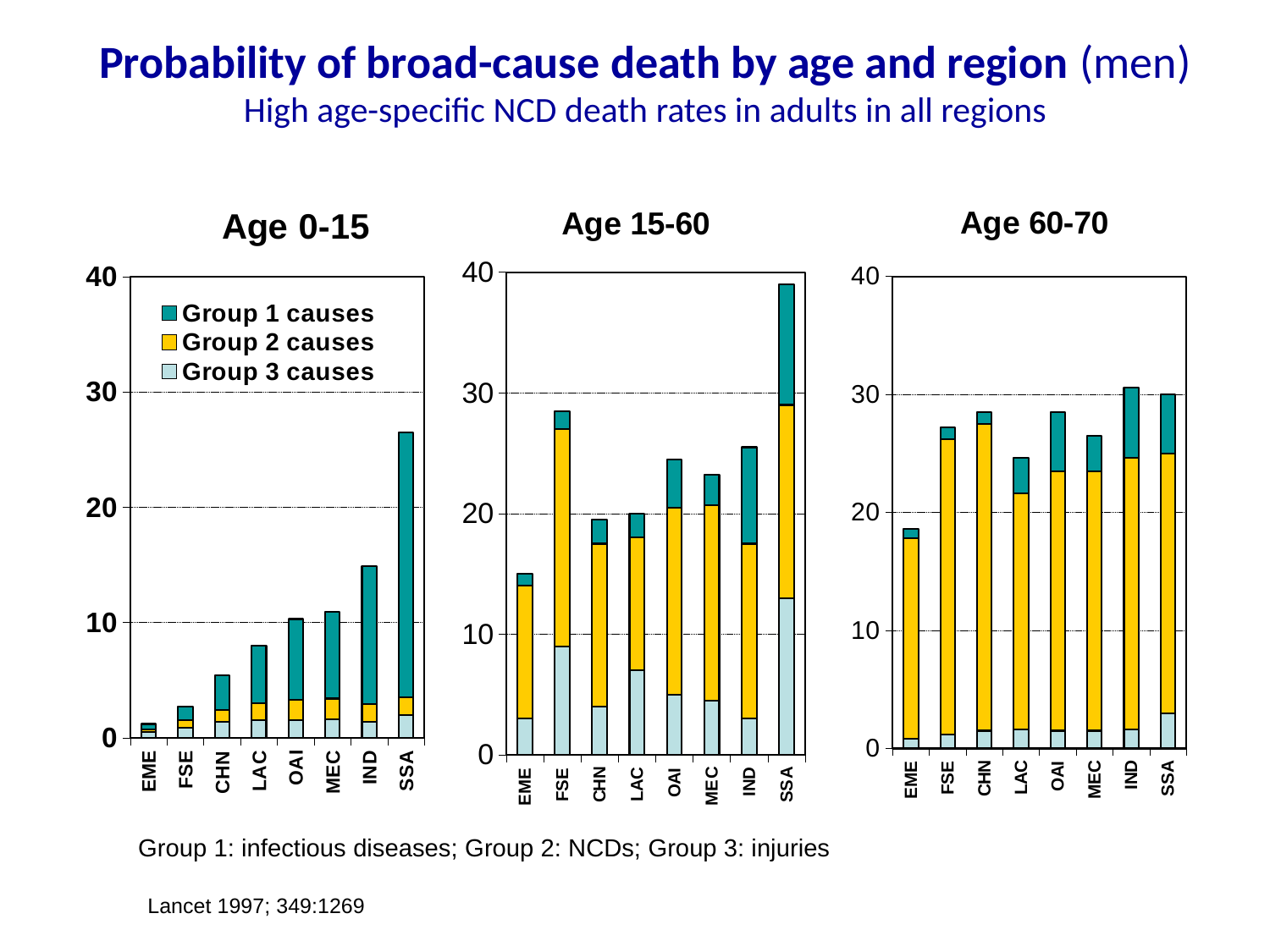
What kind of chart is the Age 0-15 chart? Stacked bar chart According to the legend on the Age 0-15 chart, what are the three series called? Group 1 causes, Group 2 causes, Group 3 causes How many regions are shown on the x axis of the Age 15-60 chart? 8 In the Age 0-15 chart, which region has the tallest total bar? SSA In the Age 0-15 chart, do the total bar heights generally rise or fall from EME to SSA along the x axis? rise In the Age 15-60 chart, is the total value for SSA greater or less than 30? greater In the Age 60-70 chart, is the total value for EME greater or less than 20? less In the Age 60-70 chart, which region has the shortest total bar? EME How many series does the legend on the Age 0-15 chart list? 3 In the Age 0-15 chart, which region has the larger total bar, IND or MEC? IND In the Age 0-15 chart, which region has the shortest total bar? EME In the Age 15-60 chart, which region has the tallest total bar? SSA